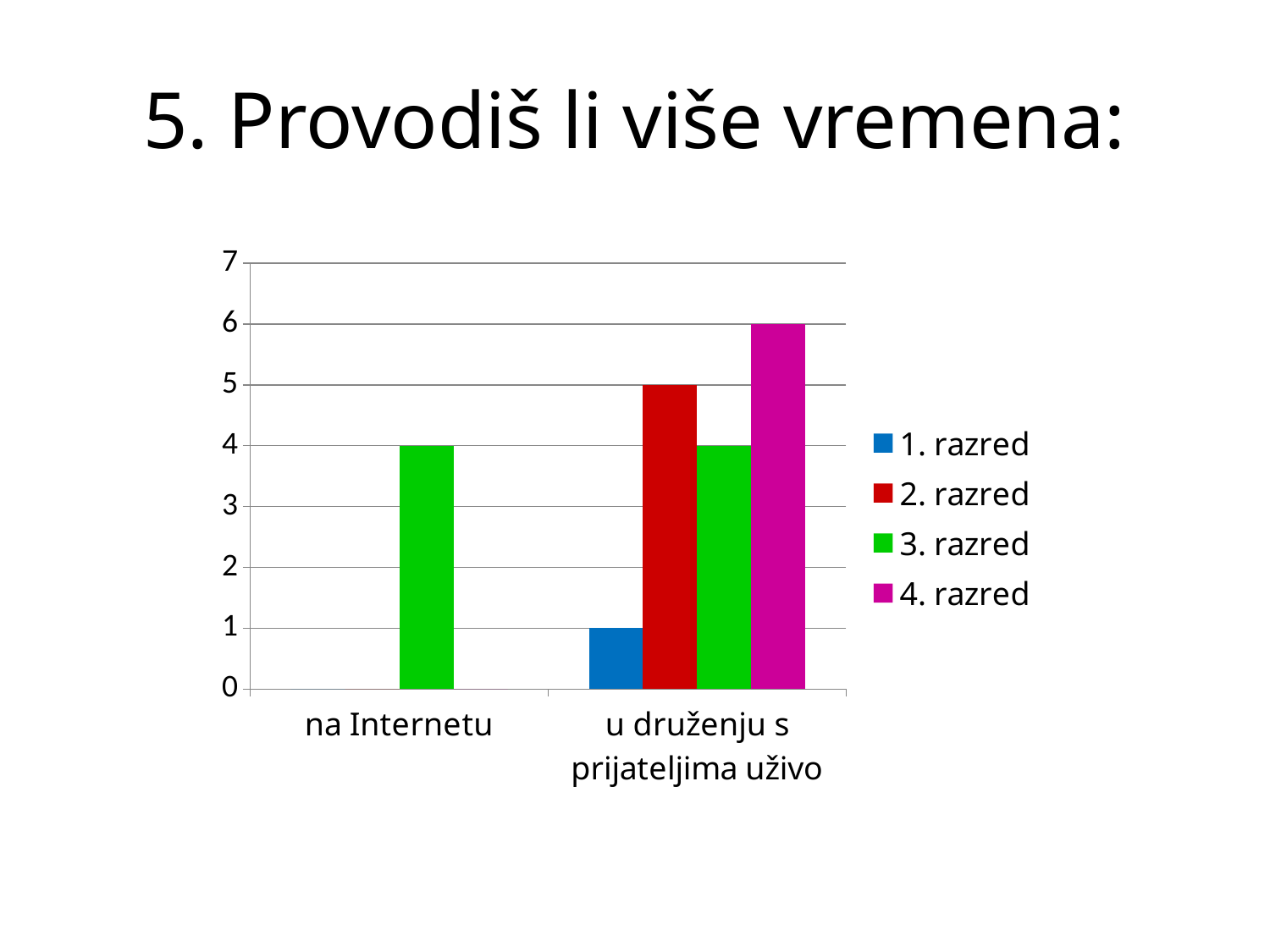
Which is larger: the value for 2. razred or for 3. razred in the category "u druženju s prijateljima uživo"? 2. razred How many series does the legend list? 4 What is the difference between the values for 4. razred and 1. razred in the category "u druženju s prijateljima uživo"? 5 Which series has the lowest value in the category "u druženju s prijateljima uživo"? 1. razred How many categories are shown on the x axis? 2 What is the value for 4. razred in the category "u druženju s prijateljima uživo"? 6 What is the value for 2. razred in the category "u druženju s prijateljima uživo"? 5 What is the value for 3. razred in the category "na Internetu"? 4 What kind of chart is shown on the slide? bar chart Which series has the highest value in the category "u druženju s prijateljima uživo"? 4. razred What is the value for 1. razred in the category "u druženju s prijateljima uživo"? 1 What is the title of the slide? 5. Provodiš li više vremena: